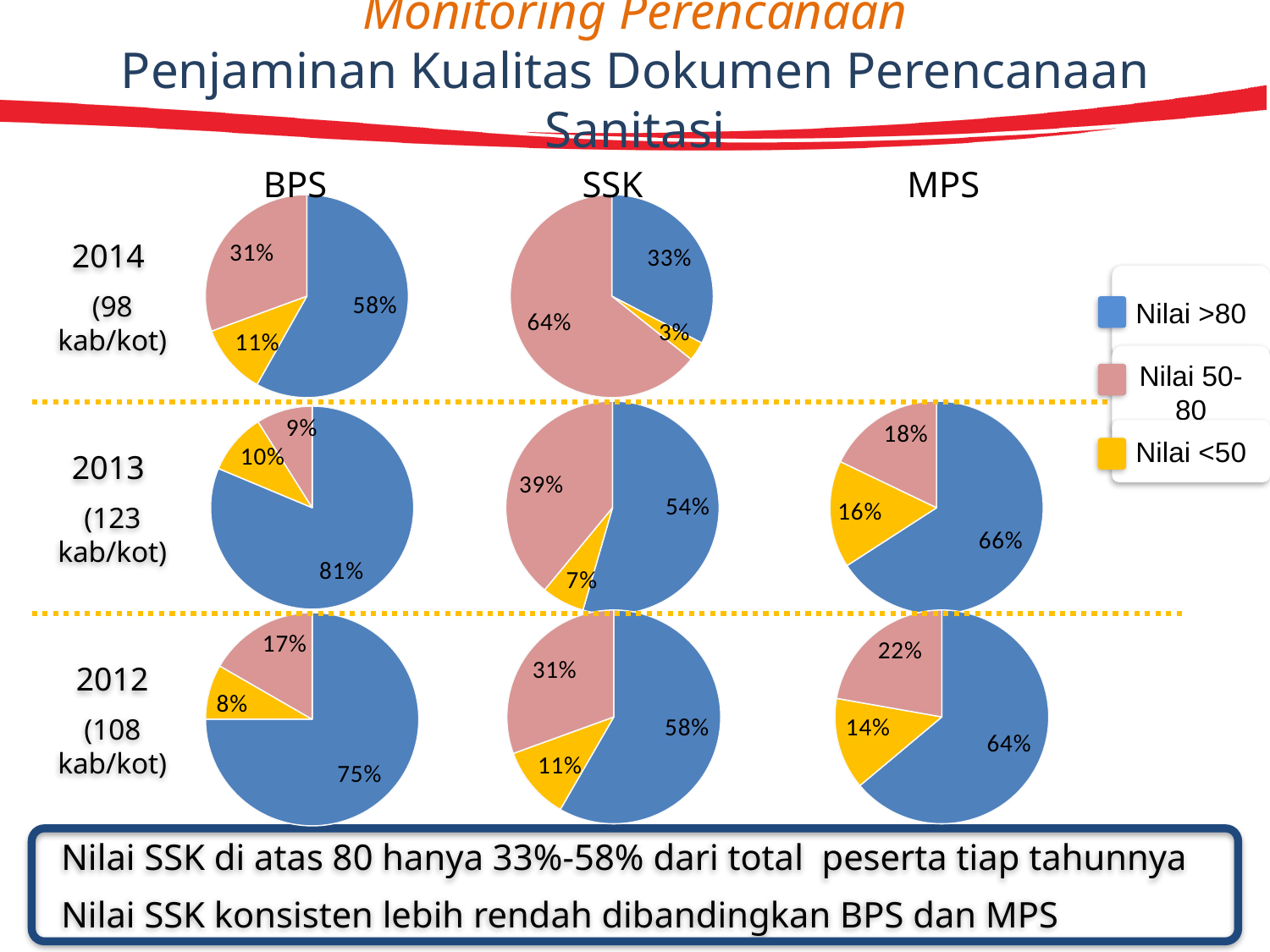
In the SSK 2012 pie chart, what share is labelled for Nilai <50? 11% How many pie charts are shown on the slide? 8 How many categories does the legend list? 3 In the SSK 2014 pie chart, which category has the largest slice? Nilai 50-80 In the MPS 2012 pie chart, which category has the smallest slice? Nilai <50 What is the difference between the Nilai >80 share in the BPS 2013 pie chart and the Nilai >80 share in the SSK 2013 pie chart? 27% In the MPS 2013 pie chart, what share is labelled for Nilai <50? 16% In the BPS 2013 pie chart, what share is labelled for Nilai >80? 81% Which is larger: the Nilai >80 share in the MPS 2012 pie chart or the Nilai >80 share in the SSK 2012 pie chart? MPS 2012 What type of charts are shown on the slide? Pie charts In the BPS 2014 pie chart, what share is labelled for Nilai >80? 58% In the SSK 2014 pie chart, what share is labelled for Nilai 50-80? 64%